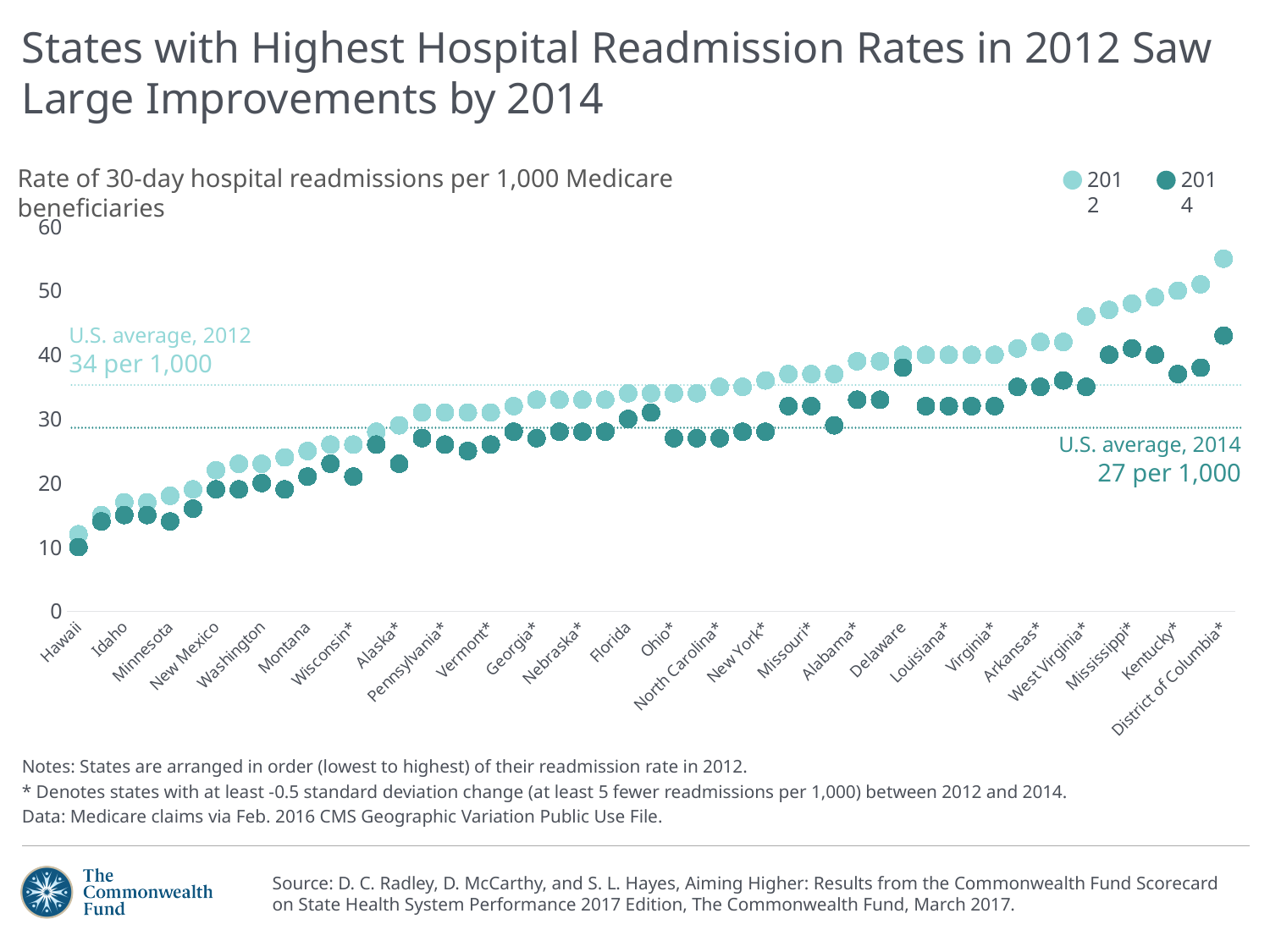
Which state has the highest 2012 readmission rate on the chart? District of Columbia Which state has the lowest 2012 readmission rate on the chart? Hawaii Do the 2012 values rise or fall moving from left to right along the x axis? rise What does an asterisk next to a state name denote on this chart? States with at least -0.5 standard deviation change (at least 5 fewer readmissions per 1,000) between 2012 and 2014 Is the 2014 value for Hawaii greater or less than 20? less Is the 2012 value for District of Columbia greater or less than 50? greater What kind of chart is shown on the slide? Dot plot (scatter chart) By how much did the U.S. average readmission rate fall between 2012 and 2014? 7 per 1,000 What is the U.S. average readmission rate for 2014 shown on the chart? 27 per 1,000 What is the U.S. average readmission rate for 2012 shown on the chart? 34 per 1,000 For District of Columbia, which is larger: the 2012 value or the 2014 value? 2012 How many series does the legend list? 2